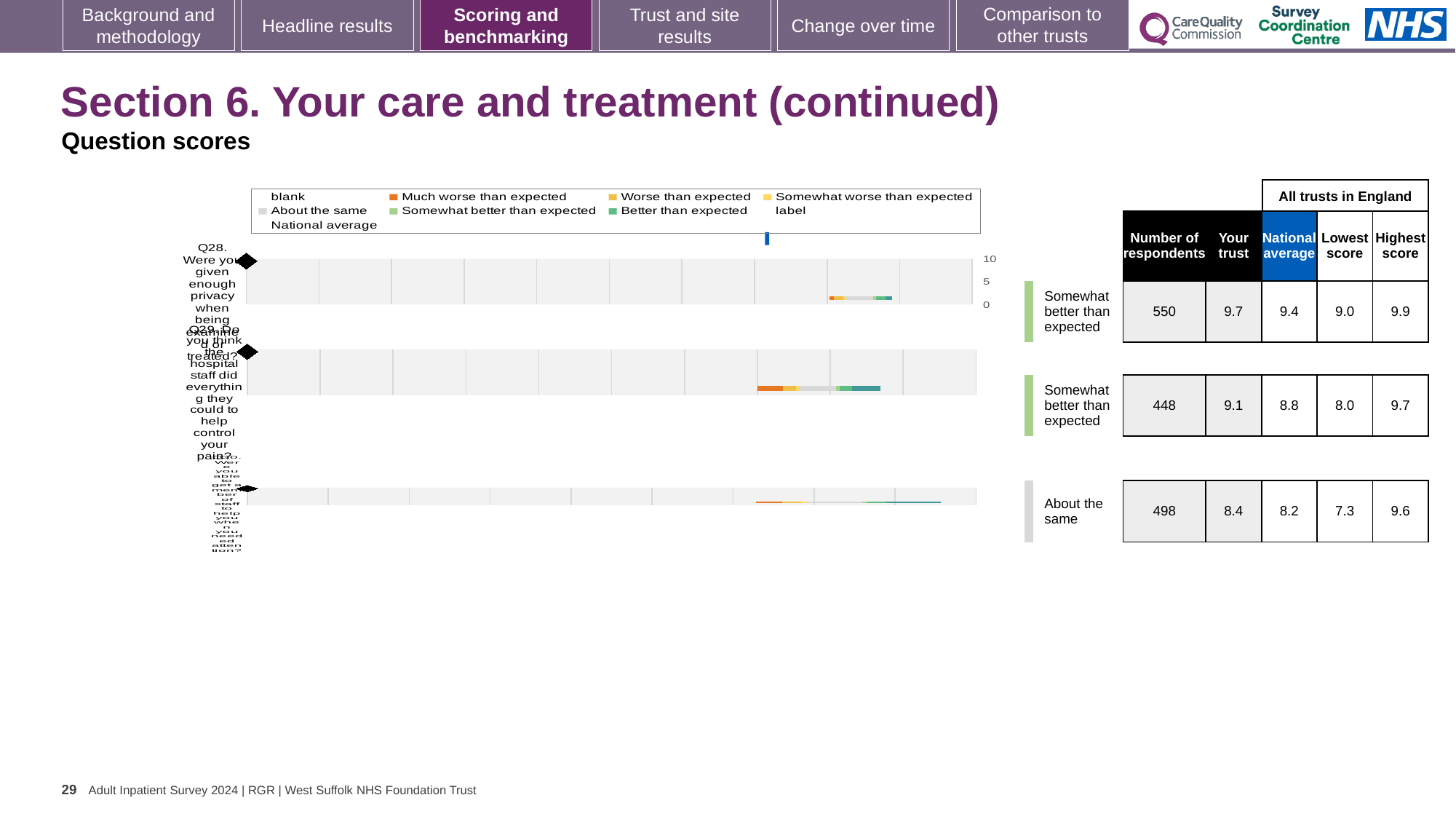
Which question has the highest 'Your trust' score? Q28 How many questions are plotted on the chart? 3 What is the difference between the trust score and the national average for Q29? 0.3 What is the national average score for Q29 (Do you think the hospital staff did everything they could to help control your pain?)? 8.8 What kind of chart is shown on the slide? Bar chart What benchmark category is shown for Q30? About the same What is the lowest score among all trusts in England for Q29? 8.0 Which question has the lowest 'Your trust' score? Q30 What is the 'Your trust' score for Q28 (Were you given enough privacy when being examined or treated?)? 9.7 Which has the higher 'Your trust' score, Q28 or Q29? Q28 What is the highest score among all trusts in England for the third question (Q30)? 9.6 How many respondents answered Q28? 550